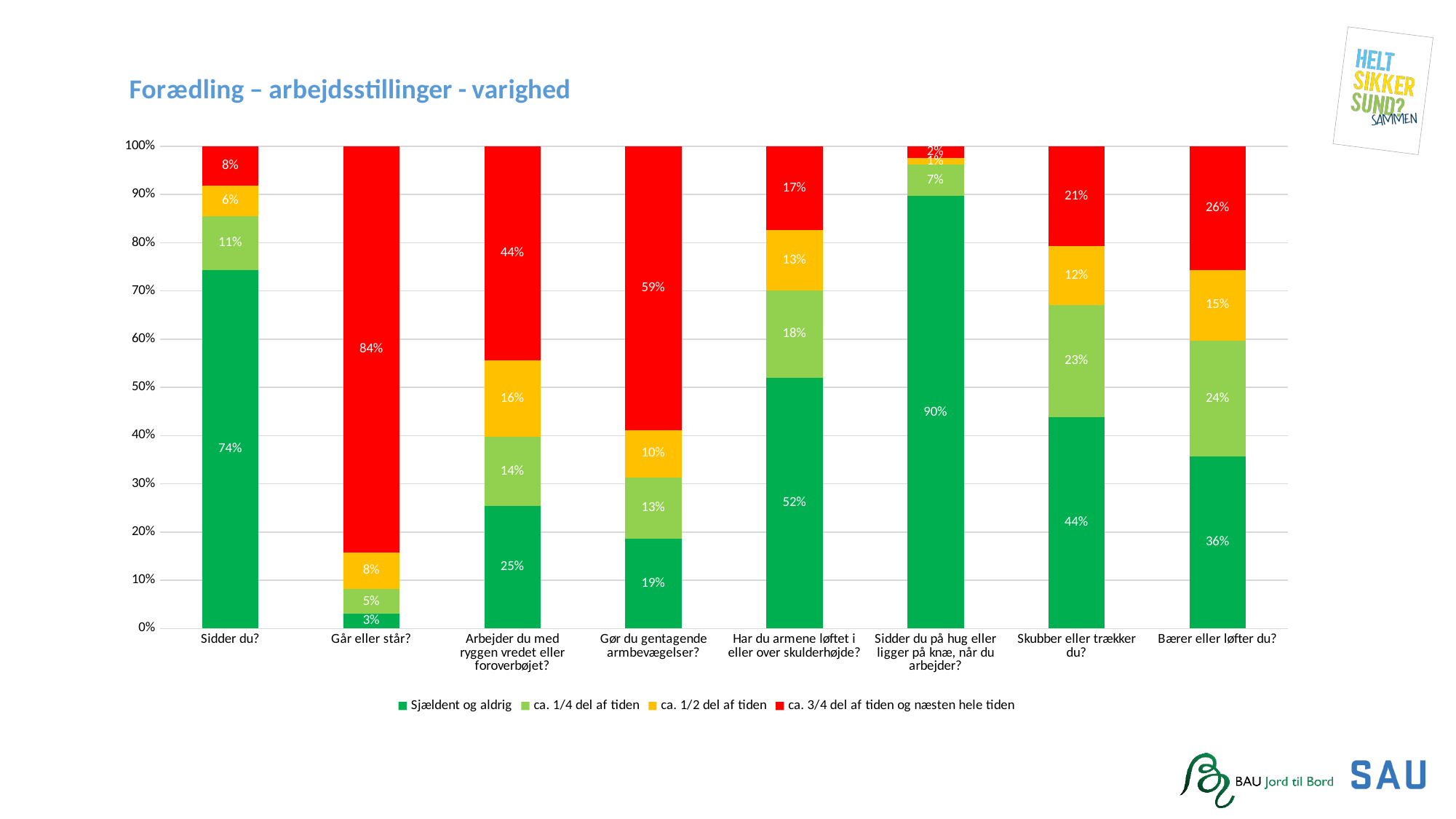
What is the difference between the 'ca. 3/4 del af tiden og næsten hele tiden' values for 'Gør du gentagende armbevægelser?' and 'Bærer eller løfter du?'? 33% What is the value of 'ca. 1/4 del af tiden' for 'Skubber eller trækker du?'? 23% How many series does the legend list? 4 Which is larger: the 'Sjældent og aldrig' value for 'Har du armene løftet i eller over skulderhøjde?' or for 'Skubber eller trækker du?'? Har du armene løftet i eller over skulderhøjde? What is the value of 'Sjældent og aldrig' for 'Sidder du?'? 74% Which category has the lowest value for 'Sjældent og aldrig'? Går eller står? What is the title of the chart? Forædling – arbejdsstillinger - varighed What type of chart is shown on the slide? Stacked bar chart Which category has the highest value for 'Sjældent og aldrig'? Sidder du på hug eller ligger på knæ, når du arbejder? What is the value of 'ca. 3/4 del af tiden og næsten hele tiden' for 'Går eller står?'? 84% How many categories (questions) are shown along the x axis? 8 What is the value of 'ca. 1/2 del af tiden' for 'Arbejder du med ryggen vredet eller foroverbøjet?'? 16%